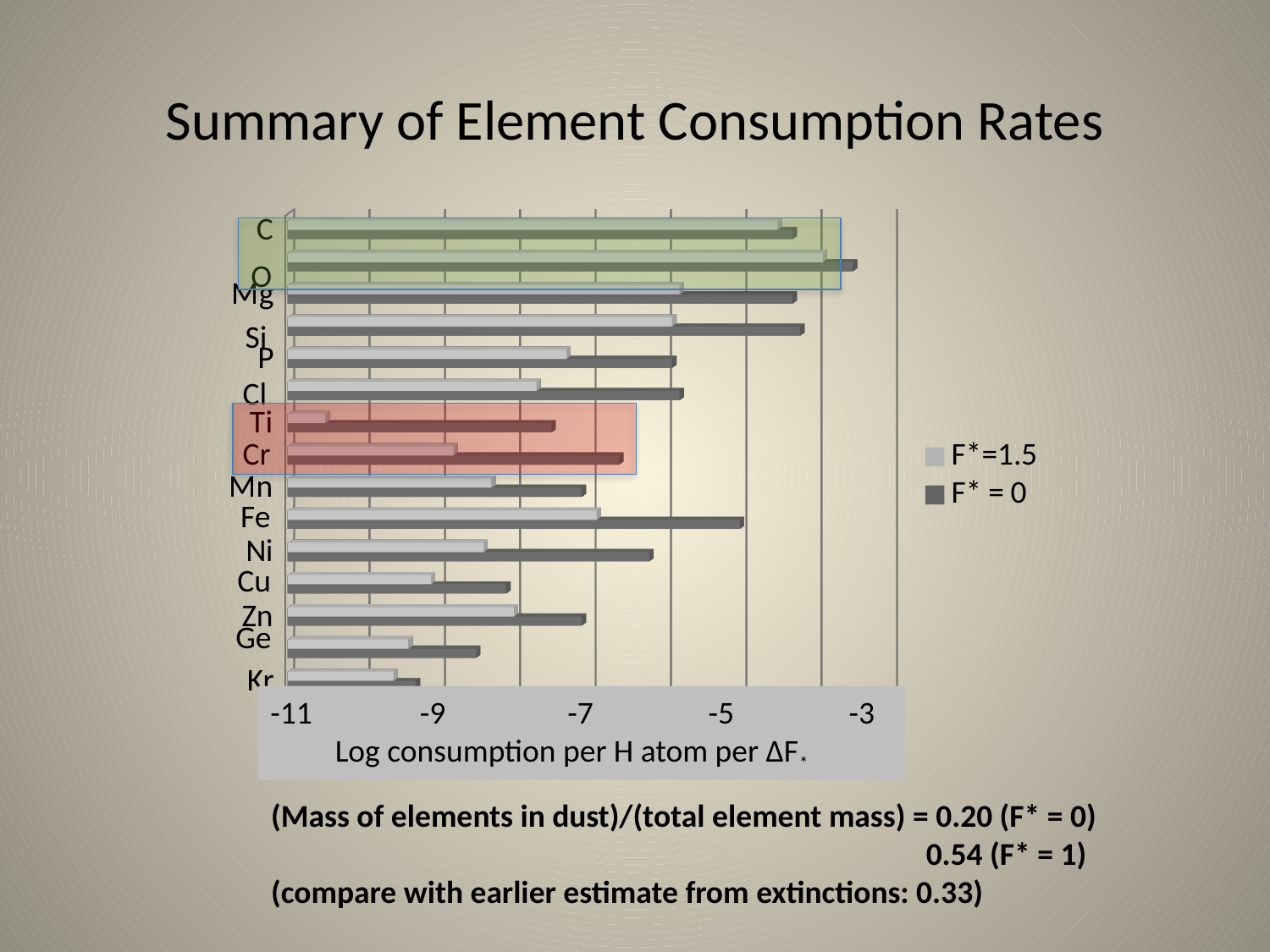
Which element has the lowest F* = 0 value? Kr What is the label of the horizontal axis? Log consumption per H atom per ΔF* Is the F*=1.5 value for Ge greater or less than -7? less Which element has the highest F* = 0 value? O How many elements (categories) are plotted on the chart? 15 Is the F* = 0 value for Cr greater or less than -7? greater Is the F*=1.5 value for Ti greater or less than -9? less For the F* = 0 series, which is larger: Fe or Ni? Fe Which element has the lowest F*=1.5 value? Ti How many series does the legend list? 2 What kind of chart is shown on the slide? Bar chart